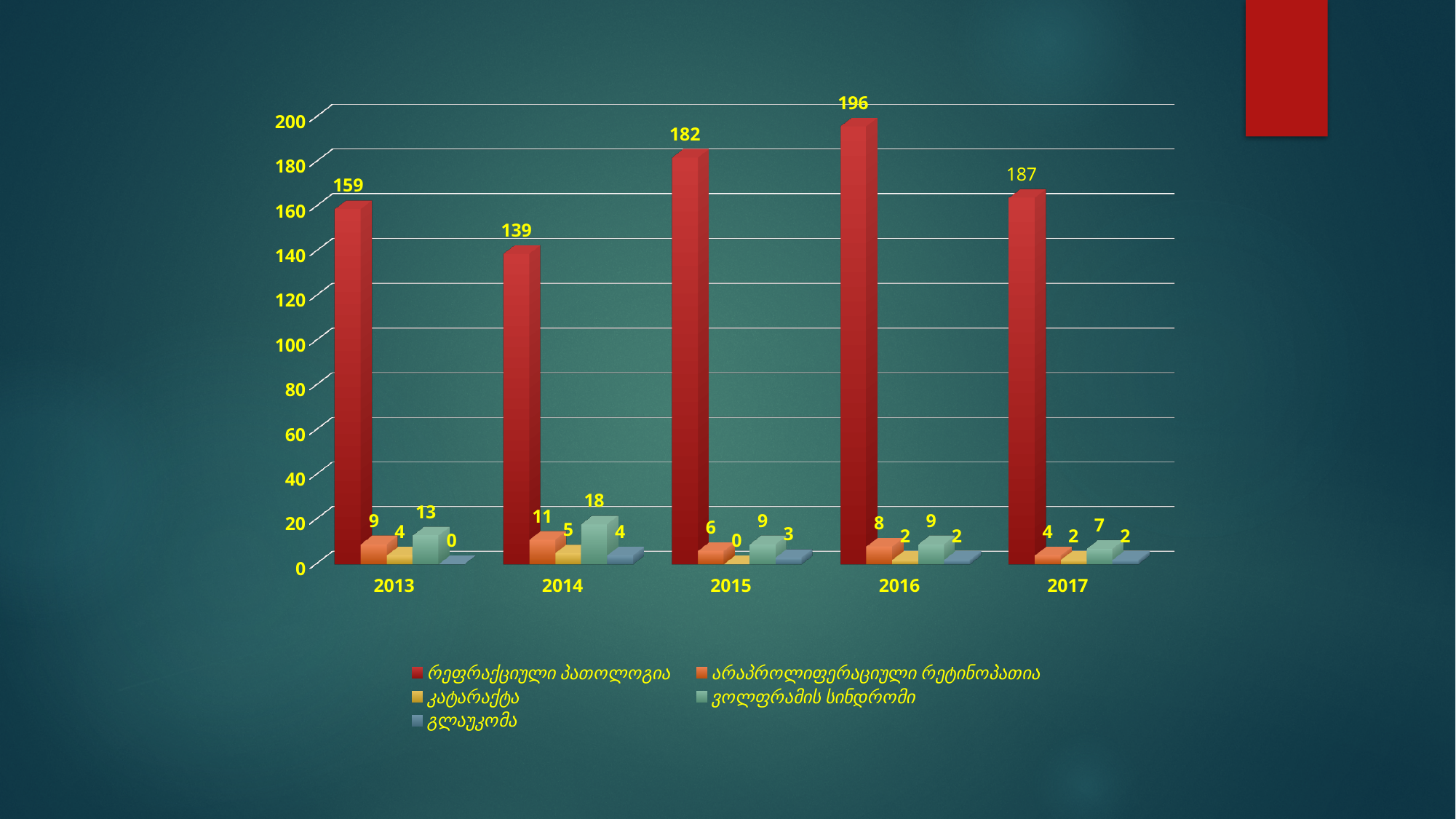
Which is larger: the კატარაქტა value in 2014 or in 2016? 2014 How many years are shown on the x axis? 5 What is the value for გლაუკომა in 2013? 0 How many series does the legend list? 5 What is the value for რეფრაქციული პათოლოგია in 2016? 196 In which year is the value for რეფრაქციული პათოლოგია the highest? 2016 What is the difference between the რეფრაქციული პათოლოგია values for 2016 and 2017? 9 Is the value for რეფრაქციული პათოლოგია in 2015 greater or less than 160? greater What is the value for არაპროლიფერაციული რეტინოპათია in 2015? 6 What kind of chart is shown on the slide? Bar chart What is the value for ვოლფრამის სინდრომი in 2014? 18 In which year is the value for რეფრაქციული პათოლოგია the lowest? 2014